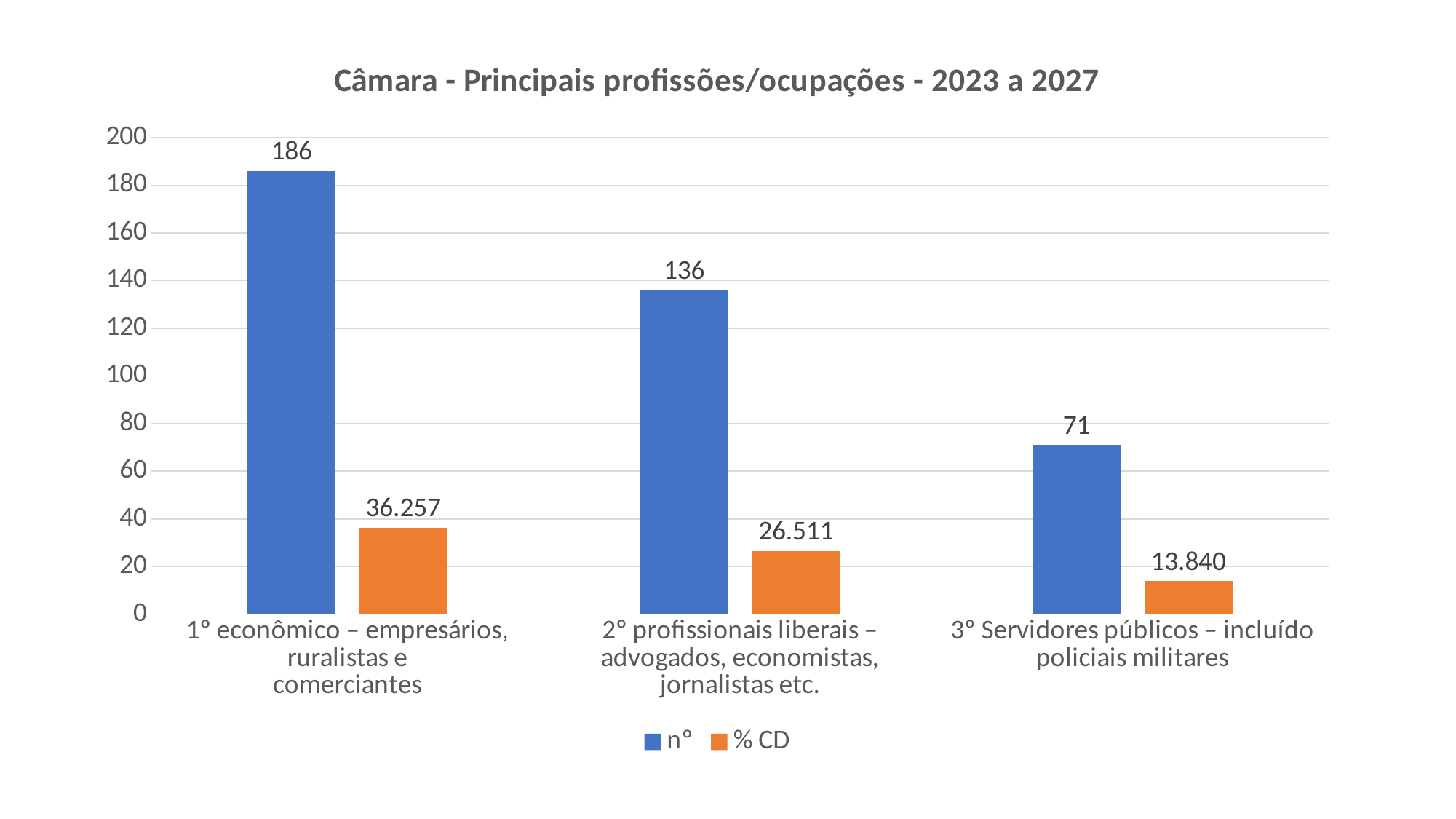
What is the n° value for the category '1° econômico – empresários, ruralistas e comerciantes'? 186 What is the n° value for '3° Servidores públicos – incluído policiais militares'? 71 How many categories are shown on the x axis? 3 What type of chart is shown on the slide? Bar chart What is the % CD value for '3° Servidores públicos – incluído policiais militares'? 13.840 Which category has the lowest % CD value? 3° Servidores públicos – incluído policiais militares Which is larger: the n° value for '2° profissionais liberais' or for '3° Servidores públicos'? 2° profissionais liberais How many series does the legend list? 2 Which category has the highest n° value? 1° econômico – empresários, ruralistas e comerciantes Is the n° value for '2° profissionais liberais' greater or less than 120? greater What is the difference between the n° values for '1° econômico' and '2° profissionais liberais'? 50 What is the % CD value for the category '2° profissionais liberais – advogados, economistas, jornalistas etc.'? 26.511